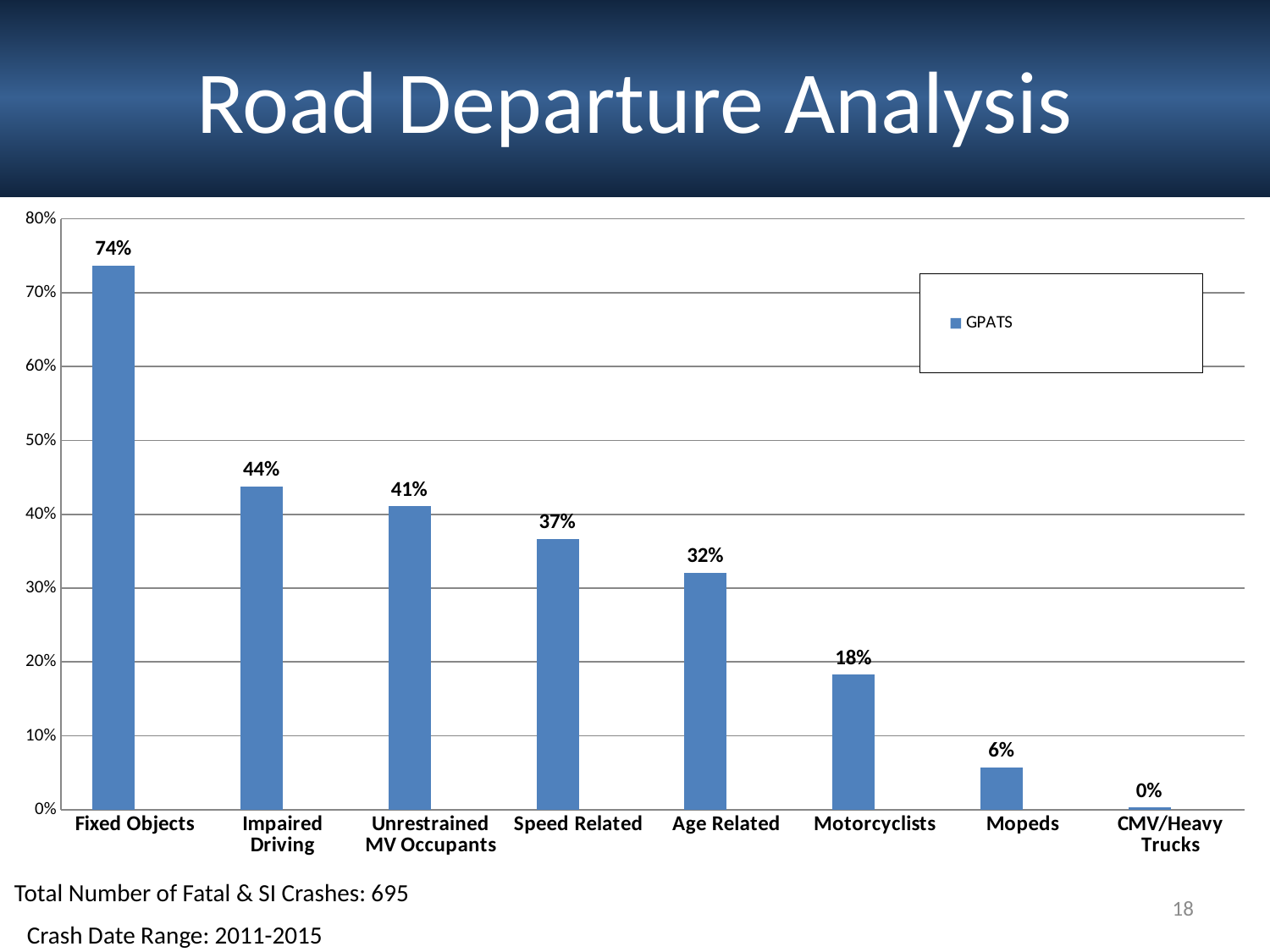
What is the value for Mopeds? 6% Which category has the lowest value? CMV/Heavy Trucks Which category has the highest value? Fixed Objects How many series does the legend list? 1 Which is larger, the value for Age Related or the value for Unrestrained MV Occupants? Unrestrained MV Occupants Is the value for Speed Related greater or less than 40%? less What is the difference between the values for Impaired Driving and Speed Related? 7% What is the name of the series shown in the legend? GPATS What is the value for Motorcyclists? 18% How many categories are shown on the x axis? 8 What is the value for Fixed Objects? 74% What kind of chart is shown on the slide? bar chart